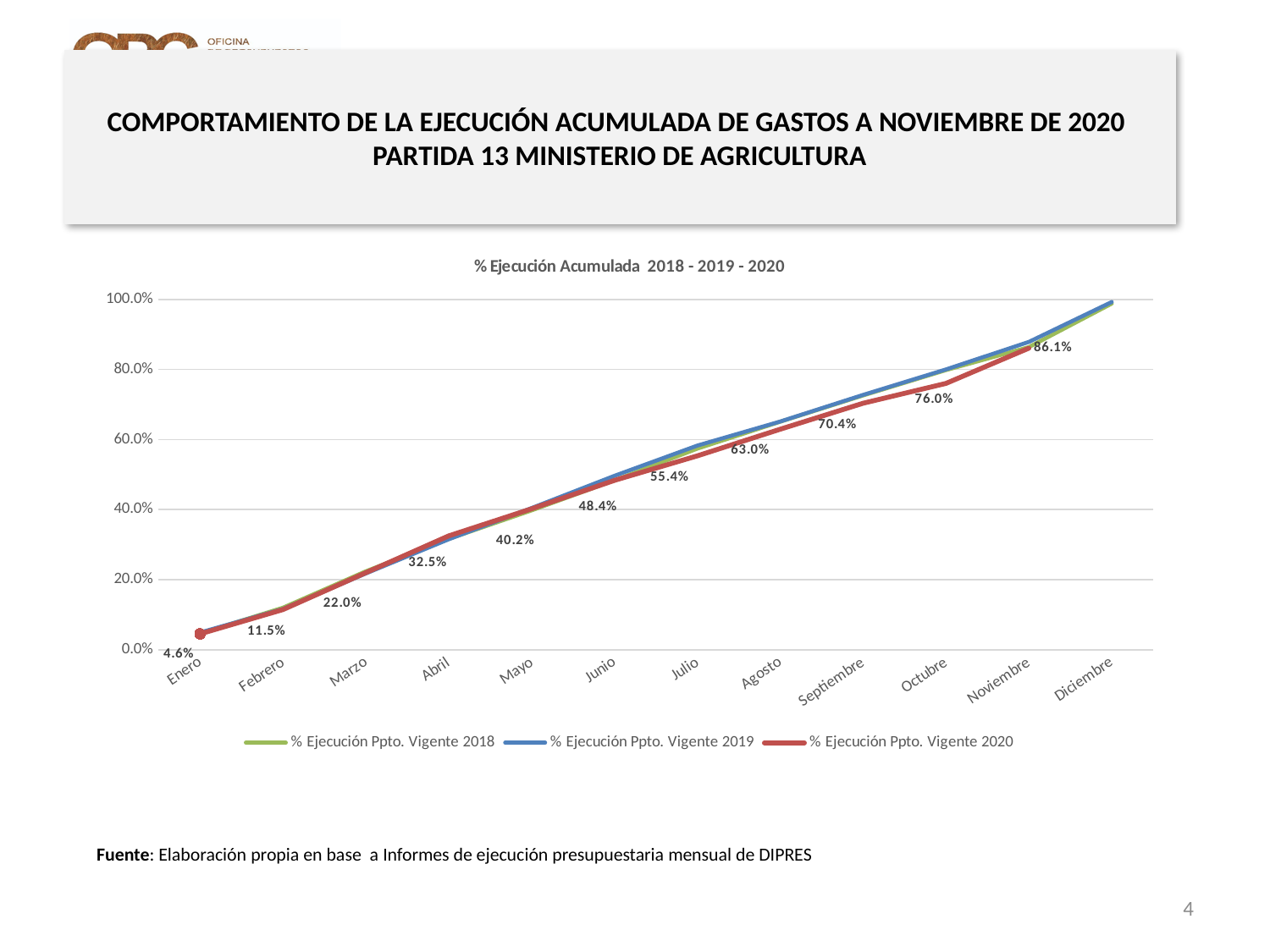
Is the value for % Ejecución Ppto. Vigente 2019 in Diciembre greater or less than 80.0%? greater How many series does the legend list? 3 What is the value for % Ejecución Ppto. Vigente 2020 in Noviembre? 86.1% What is the difference between the 2020 values for Marzo and Febrero? 10.5% What is the value for % Ejecución Ppto. Vigente 2020 in Junio? 48.4% Do the values of the % Ejecución Ppto. Vigente 2020 series rise or fall from Enero to Noviembre? rise What is the value for % Ejecución Ppto. Vigente 2020 in Septiembre? 70.4% What is the title of the chart? % Ejecución Acumulada 2018 - 2019 - 2020 What kind of chart is shown on the slide? line chart What is the value for % Ejecución Ppto. Vigente 2020 in Enero? 4.6% How many months are shown on the x axis? 12 What is the difference between the 2020 values for Noviembre and Octubre? 10.1%